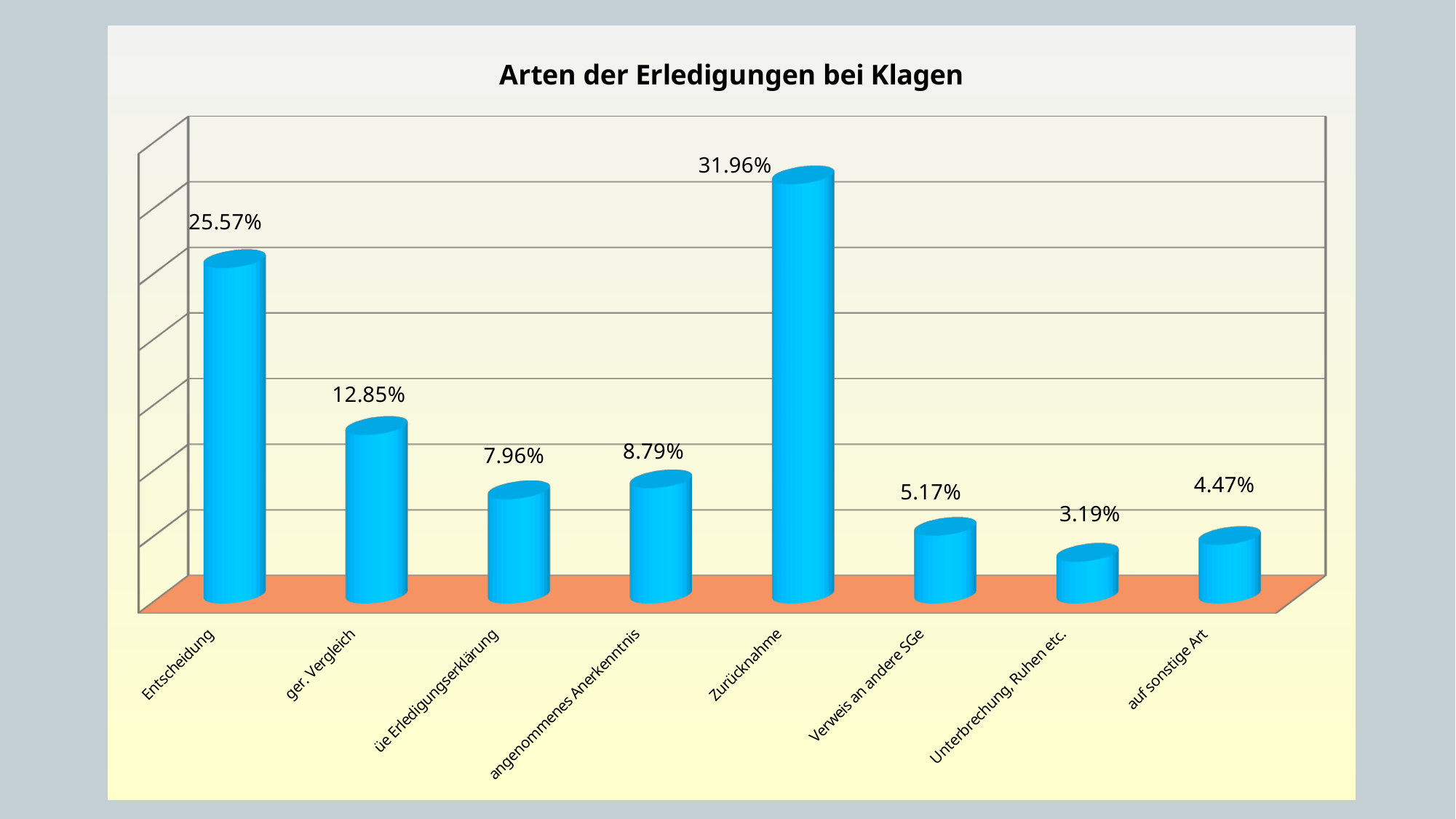
What is the difference between the values for Zurücknahme and Entscheidung? 6.39% What is the value for Zurücknahme? 31.96% How many categories are shown on the x axis? 8 What is the value for ger. Vergleich? 12.85% Which is larger, the value for üe Erledigungserklärung or the value for angenommenes Anerkenntnis? angenommenes Anerkenntnis What is the value for angenommenes Anerkenntnis? 8.79% Which category has the highest value? Zurücknahme Which category has the lowest value? Unterbrechung, Ruhen etc. What is the title of the chart? Arten der Erledigungen bei Klagen What kind of chart is shown on the slide? bar chart What is the value for Unterbrechung, Ruhen etc.? 3.19% What is the difference between the values for Verweis an andere SGe and auf sonstige Art? 0.70%